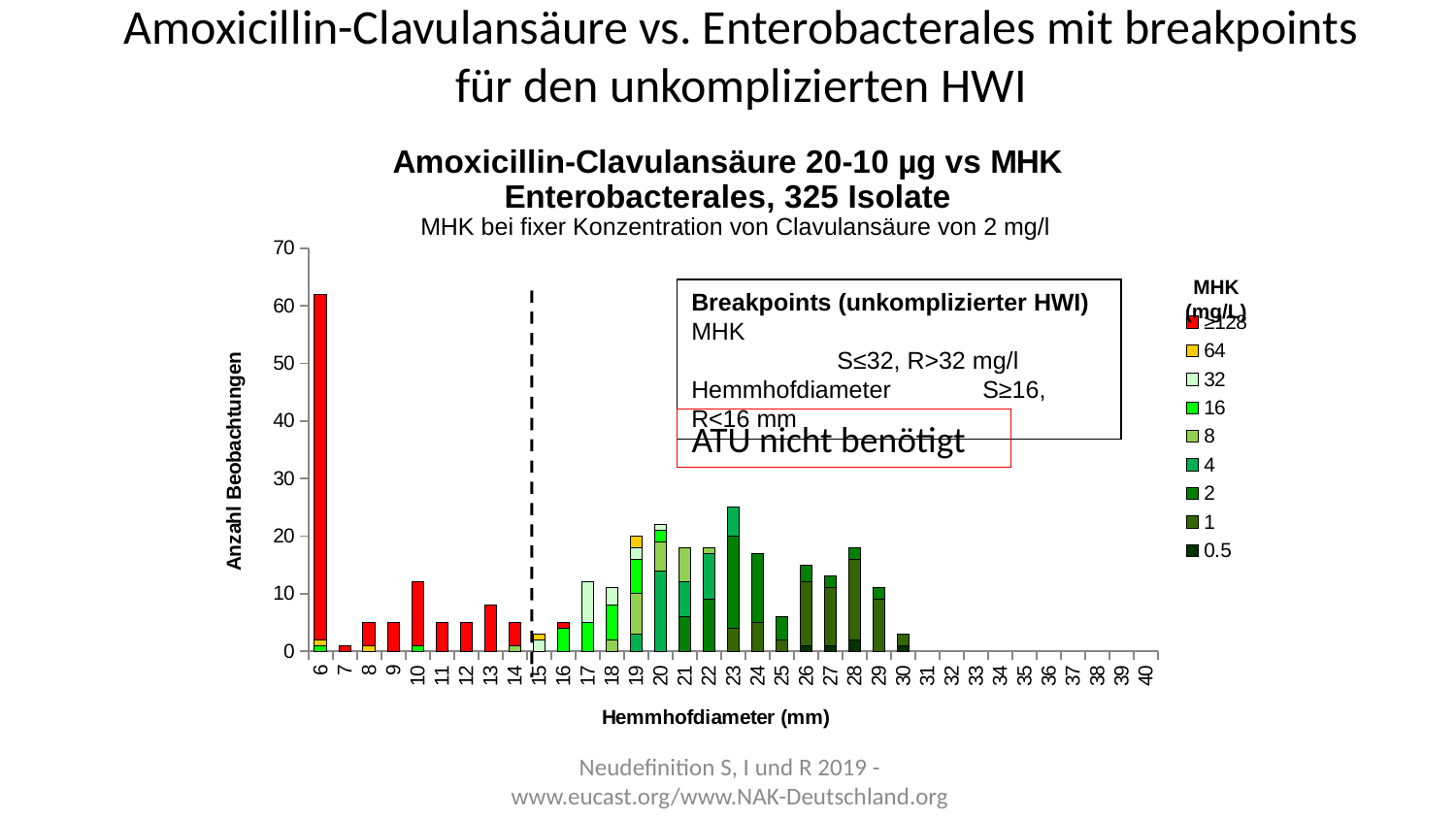
What kind of chart is shown on the slide? Stacked bar chart Which has more observations: Hemmhofdiameter 10 mm or 13 mm? 10 mm How many MHK (mg/L) series does the legend list? 9 Is the total value for Hemmhofdiameter 7 mm greater or less than 10? less Is the total value for Hemmhofdiameter 23 mm greater or less than 20? greater Is the total value for Hemmhofdiameter 6 mm greater or less than 50? greater Which Hemmhofdiameter (mm) category has the highest number of observations? 6 What is the label of the x axis? Hemmhofdiameter (mm) What is the label of the y axis? Anzahl Beobachtungen How many Hemmhofdiameter categories are shown on the x axis? 35 Which has more observations: Hemmhofdiameter 23 mm or 24 mm? 23 mm